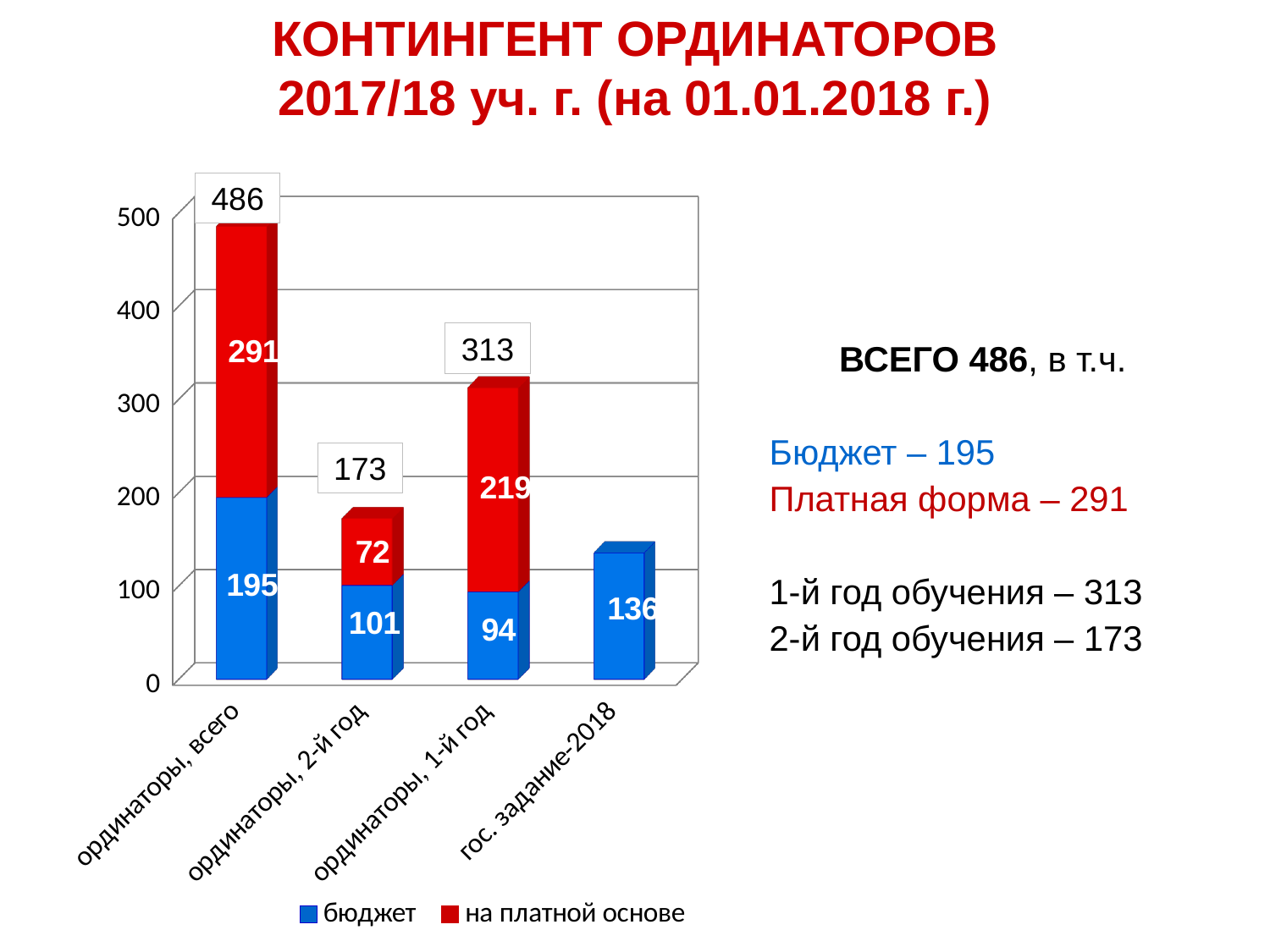
What kind of chart is shown on the slide? stacked bar chart What is the value of the 'на платной основе' series for 'ординаторы, 1-й год'? 219 What is the difference between the 'на платной основе' values for 'ординаторы, 1-й год' and 'ординаторы, 2-й год'? 147 What is the value of the 'бюджет' series for 'гос. задание-2018'? 136 What is the total of the stacked bar for 'ординаторы, 1-й год'? 313 Which colour represents the 'на платной основе' series? red How many categories are shown on the x axis? 4 What is the total of the stacked bar for 'ординаторы, 2-й год'? 173 Which category has the highest stacked total? ординаторы, всего How many series does the legend list? 2 Which is larger: the 'бюджет' value for 'ординаторы, 2-й год' or for 'ординаторы, 1-й год'? ординаторы, 2-й год What is the value of the 'бюджет' series for 'ординаторы, всего'? 195